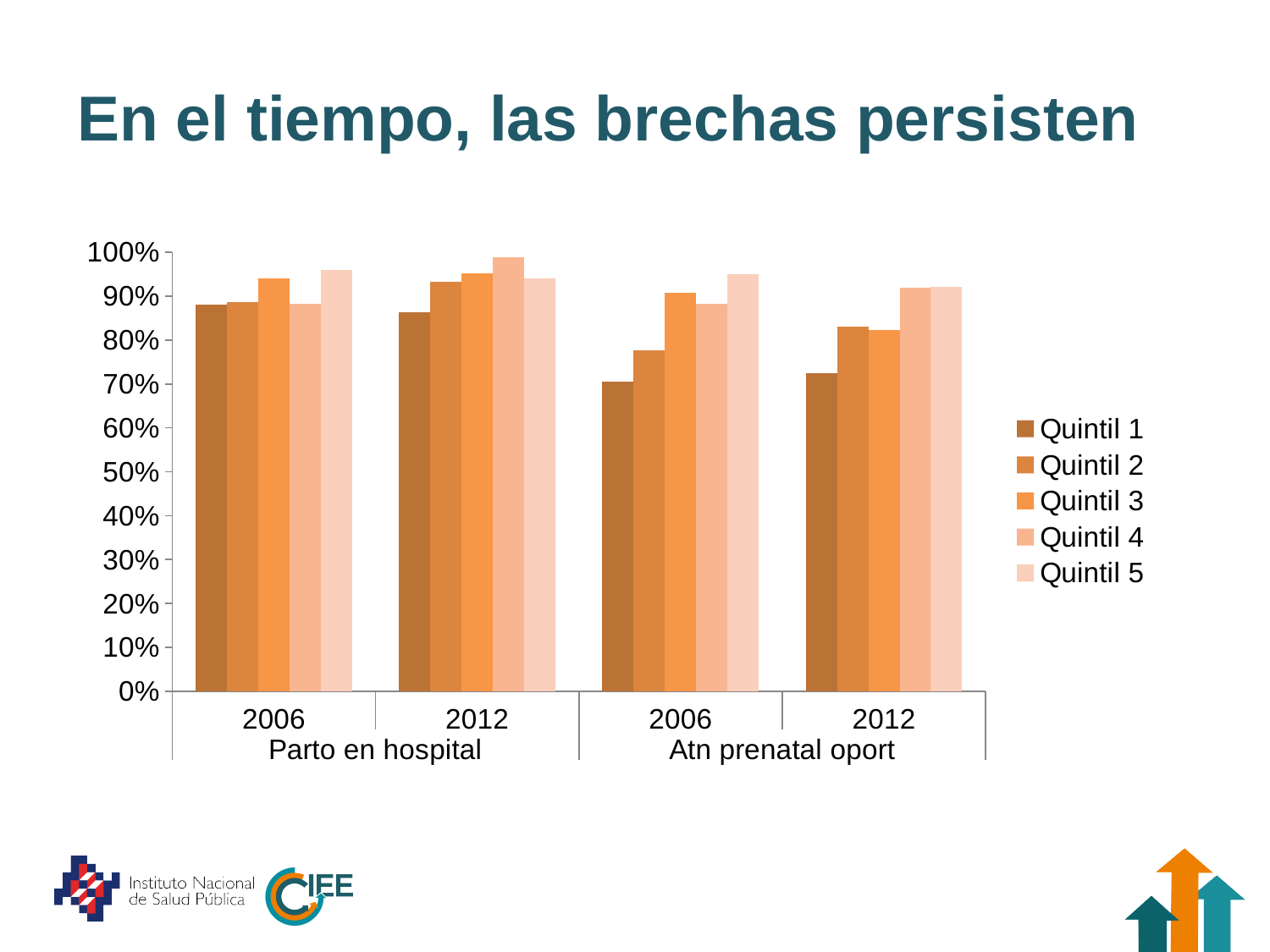
In Parto en hospital 2006, which is larger: Quintil 1 or Quintil 3? Quintil 3 Is the value for Quintil 5 in Parto en hospital 2006 greater or less than 90%? greater What kind of chart is shown on the slide? Bar chart Is the value for Quintil 4 in Atn prenatal oport 2012 greater or less than 90%? greater How many groups of bars are plotted along the x axis? 4 What is the title of the slide? En el tiempo, las brechas persisten Which quintile has the highest value in Parto en hospital 2012? Quintil 4 Which quintile has the lowest value in Atn prenatal oport 2006? Quintil 1 Is the value for Quintil 1 in Atn prenatal oport 2006 greater or less than 80%? less In Atn prenatal oport 2012, which is larger: Quintil 1 or Quintil 5? Quintil 5 How many series does the legend list? 5